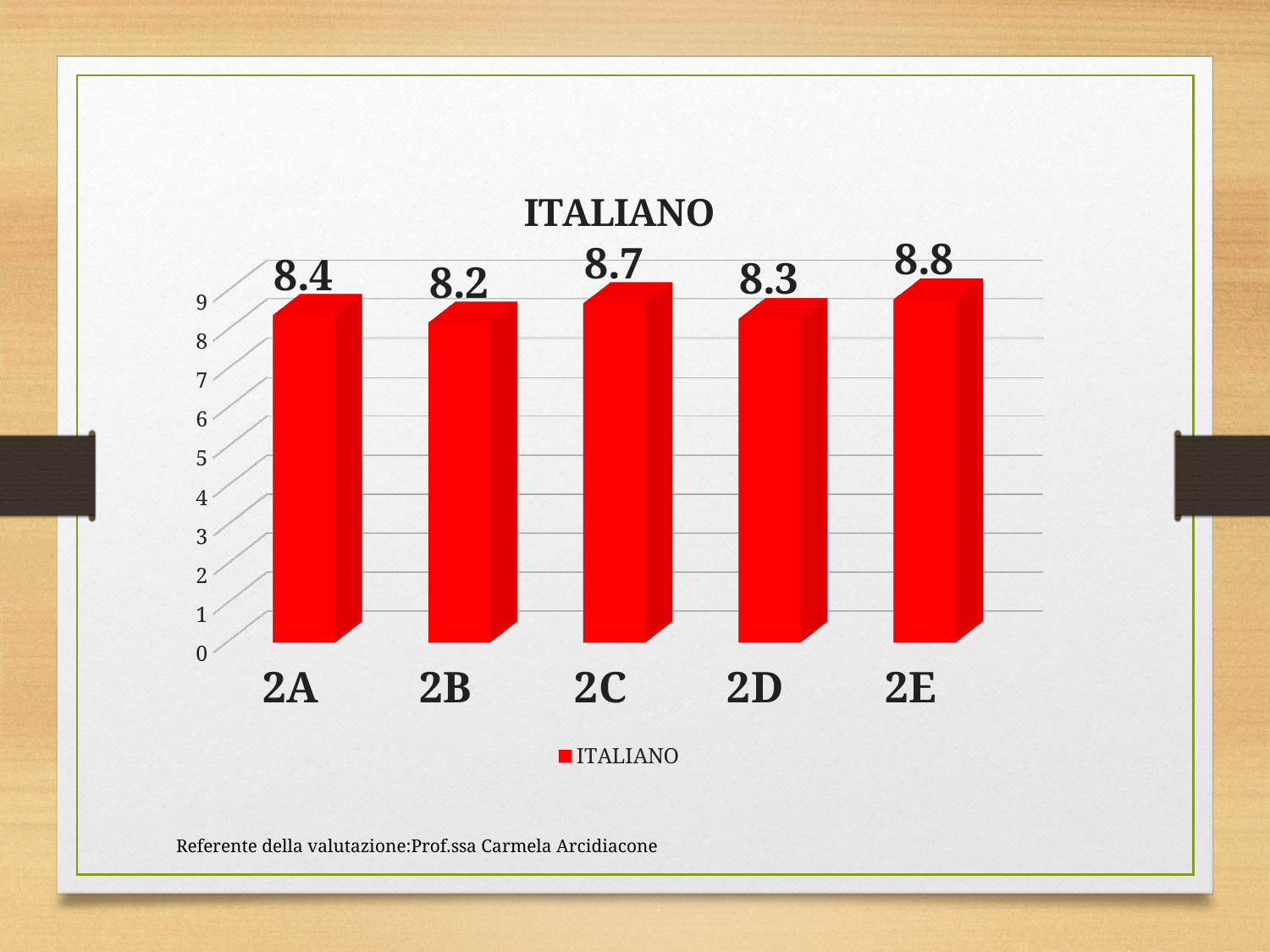
What is the value for 2A? 8.4 Which is larger, the value for 2C or the value for 2D? 2C Is the value for 2D greater or less than 8? greater How many series does the legend list? 1 What is the value for 2E? 8.8 Which class has the highest value? 2E How many classes are shown on the x axis? 5 What is the difference between the values for 2E and 2B? 0.6 Which class has the lowest value? 2B What kind of chart is shown? bar chart What is the value for 2C? 8.7 What is the title of the chart? ITALIANO